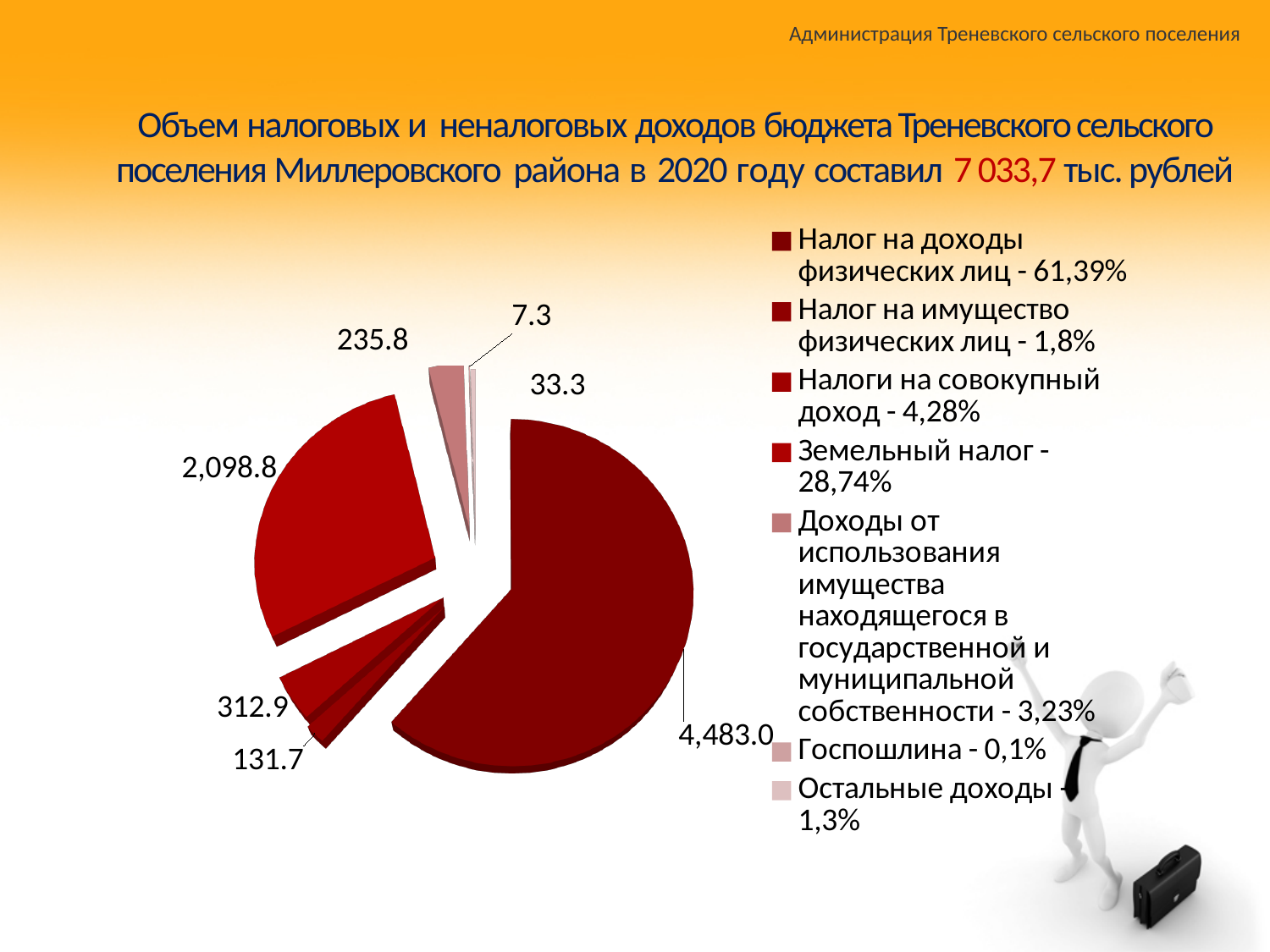
According to the legend, what share of the total does Земельный налог represent? 28,74% What is the difference between the values for Налог на доходы физических лиц (4,483.0) and Земельный налог (2,098.8)? 2,384.2 What type of chart is shown on the slide? Pie chart Which is larger: the slice for Налоги на совокупный доход or the slice for Налог на имущество физических лиц? Налоги на совокупный доход How many slices does the pie chart have? 7 What value is labelled on the slice for Налоги на совокупный доход? 312.9 What value is labelled on the slice for Земельный налог? 2,098.8 How many entries does the legend list? 7 What value is labelled on the slice for Госпошлина? 7.3 Which category has the smallest slice in the pie chart? Госпошлина Which category has the largest slice in the pie chart? Налог на доходы физических лиц What value is shown for the largest slice of the pie chart (Налог на доходы физических лиц)? 4,483.0